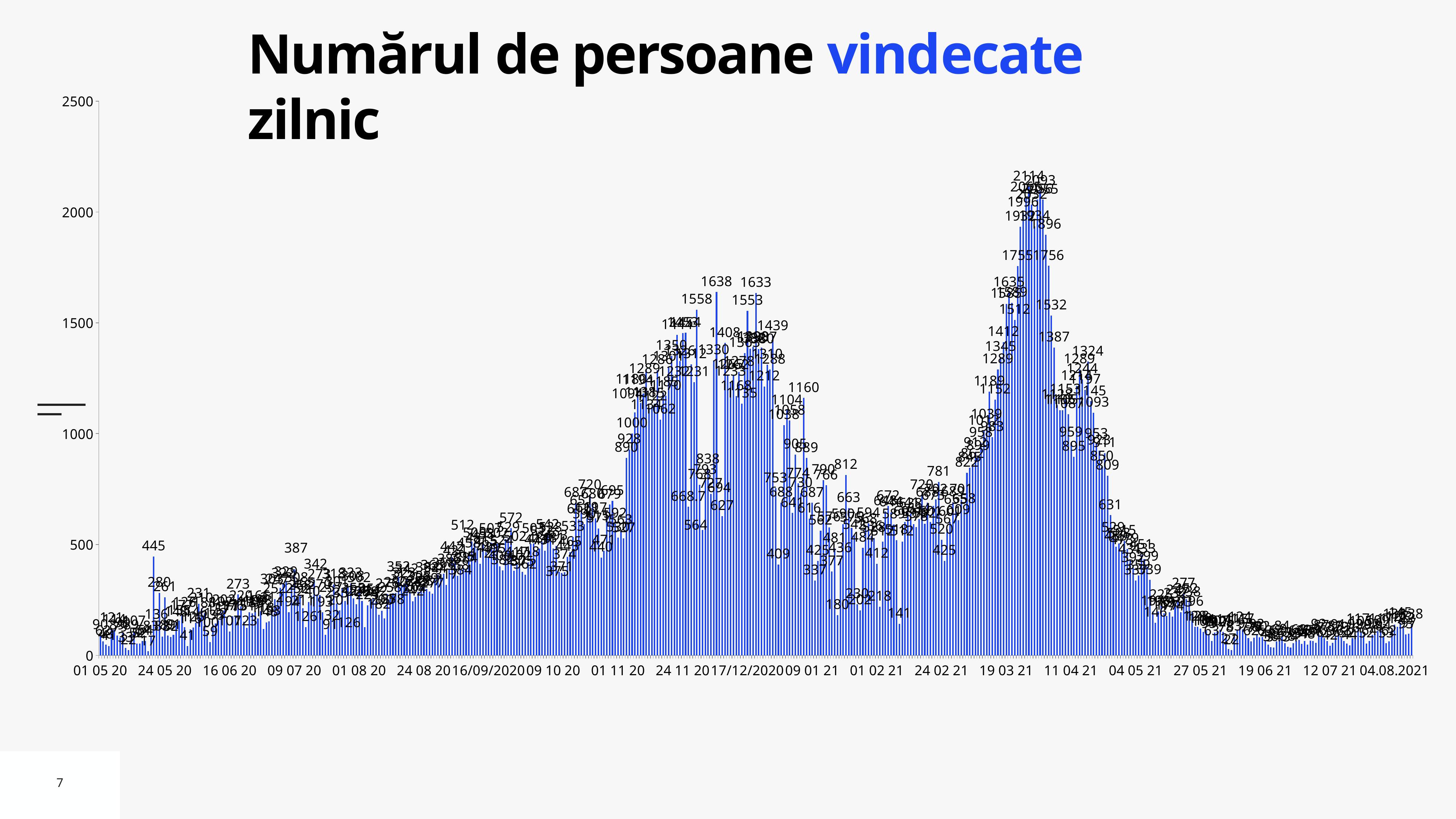
What kind of chart is shown on the slide? bar chart What is the title of the chart? Numărul de persoane vindecate zilnic Is the value for the bar at 19 06 21 greater or less than 500? less Is the value for the bar at 24 11 20 greater or less than 1000? greater What is the difference between the peak near 24 05 20 (445) and the peak near 09 07 20 (387)? 58 Which is larger: the peak near 24 05 20 (445) or the peak near 09 07 20 (387)? 445 Do the values rise or fall between 11 04 21 and 04 05 21? fall What is the maximum value shown on the vertical axis? 2500 What is the value of the tallest bar near the 24 05 20 tick? 445 What is the value of the tallest bar near the 09 07 20 tick? 387 What is the highest value labeled on the chart? 2114 Is the value for the first bar at 01 05 20 greater or less than 500? less